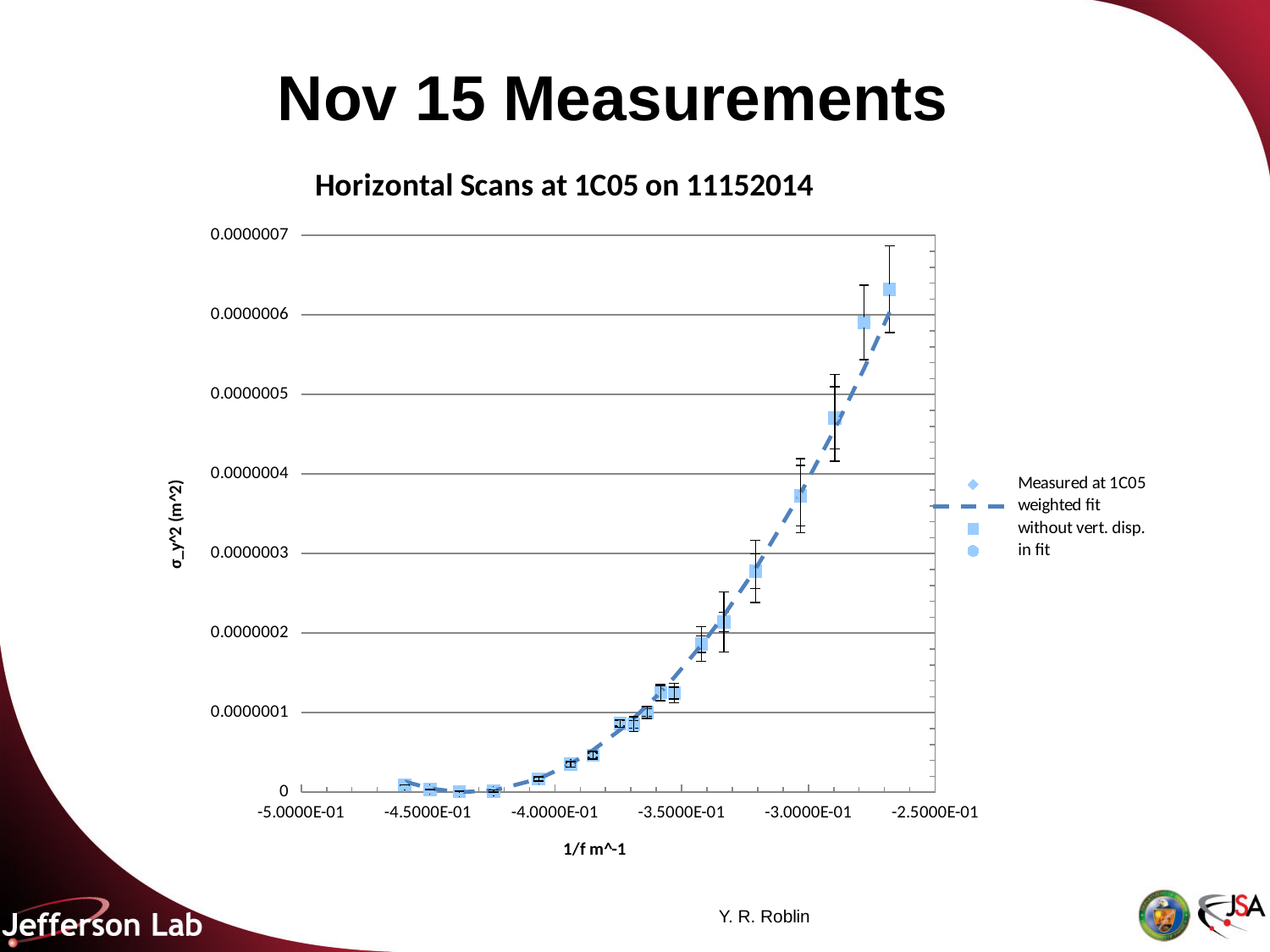
What kind of chart is shown on the slide? scatter chart How many entries does the chart's legend list? 4 What is the label of the x axis? 1/f m^-1 What is the title of the chart? Horizontal Scans at 1C05 on 11152014 Is the value of the measured point near 1/f = -3.5000E-01 greater or less than 0.0000002? less Is the value of the measured point near 1/f = -3.0000E-01 greater or less than 0.0000003? greater What is the highest value shown on the y axis? 0.0000007 Is the value of the rightmost measured point (near 1/f = -2.7E-01) greater or less than 0.0000006? greater Which is larger: the measured value near 1/f = -2.9000E-01 or the measured value near 1/f = -3.2000E-01? the value near -2.9000E-01 Do the plotted σ_y^2 values rise or fall as 1/f increases from -5.0000E-01 toward -2.5000E-01? rise